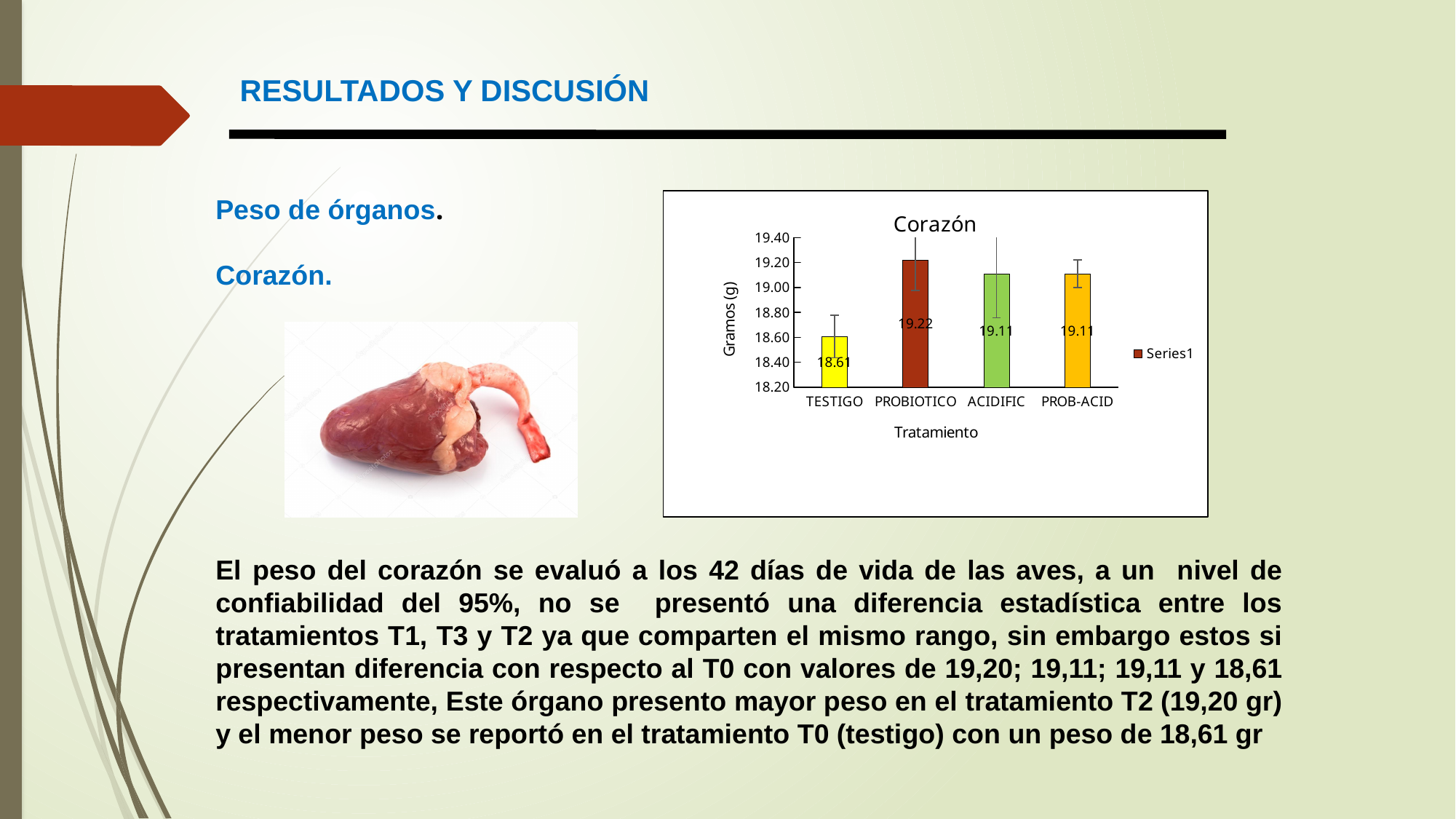
Which treatment has the highest value in the Corazón chart? PROBIOTICO What is the value for TESTIGO in the Corazón chart? 18.61 Which is larger in the Corazón chart, the value for PROBIOTICO or the value for ACIDIFIC? PROBIOTICO Which treatment has the lowest value in the Corazón chart? TESTIGO What type of chart is the Corazón chart? Bar chart How many series does the legend of the Corazón chart list? 1 What is the value for PROB-ACID in the Corazón chart? 19.11 Is the value for TESTIGO in the Corazón chart greater or less than 19.00? less What is the value for PROBIOTICO in the Corazón chart? 19.22 How many treatment categories are shown in the Corazón chart? 4 What is the difference between the PROBIOTICO and TESTIGO values in the Corazón chart? 0.61 What is the value for ACIDIFIC in the Corazón chart? 19.11